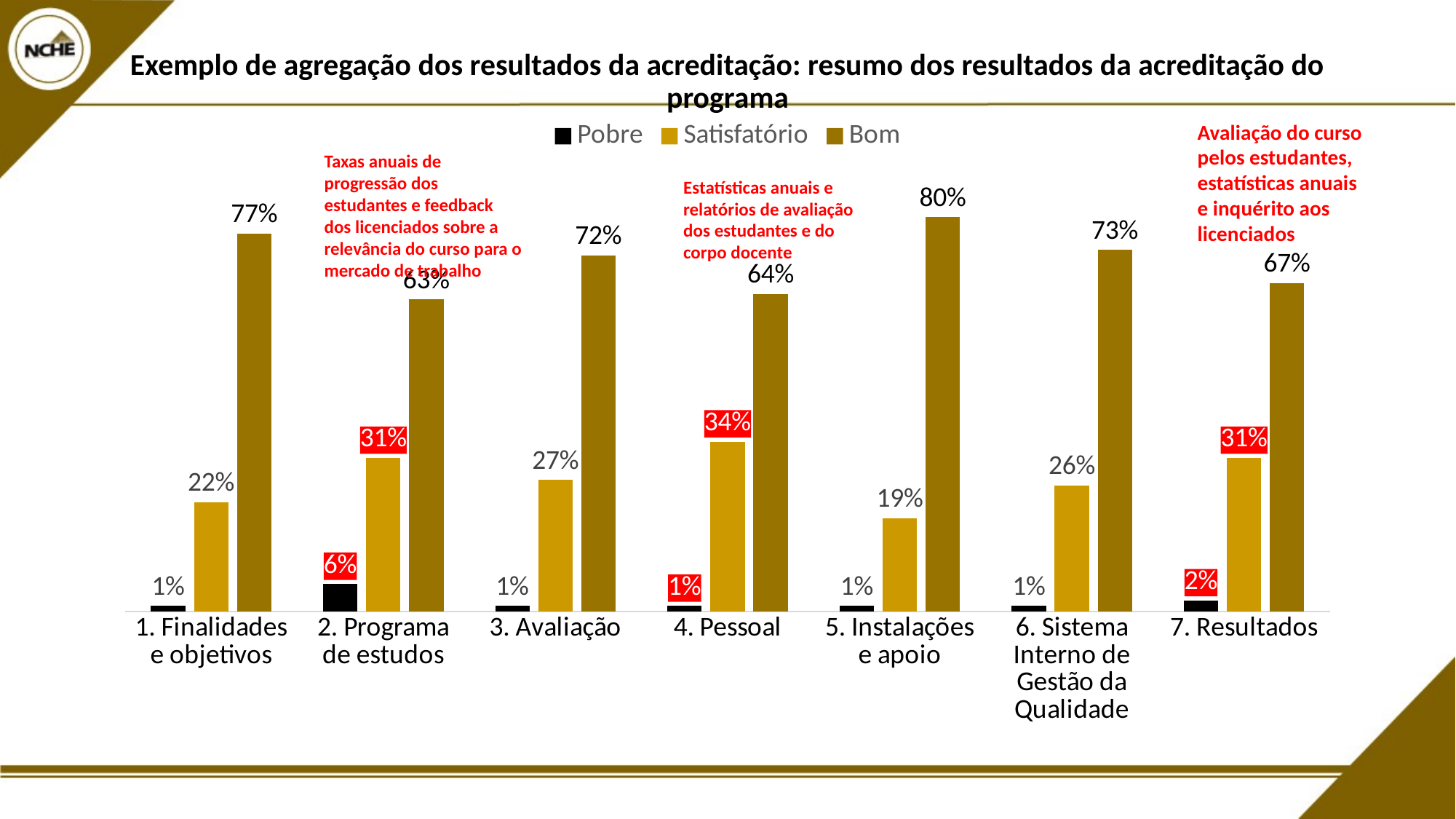
What is the value of Satisfatório for 4. Pessoal? 34% What is the difference between the Bom values for 1. Finalidades e objetivos and 7. Resultados? 10% Which is larger: the Satisfatório value for 3. Avaliação or for 6. Sistema Interno de Gestão da Qualidade? 3. Avaliação How many categories are shown on the x axis? 7 How many series does the legend list? 3 What is the value of Pobre for 2. Programa de estudos? 6% Which category has the highest Bom value? 5. Instalações e apoio What kind of chart is shown on the slide? Bar chart What is the value of Satisfatório for 7. Resultados? 31% Which category has the lowest Bom value? 2. Programa de estudos Which category has the lowest Satisfatório value? 5. Instalações e apoio What is the value of Bom for 5. Instalações e apoio? 80%